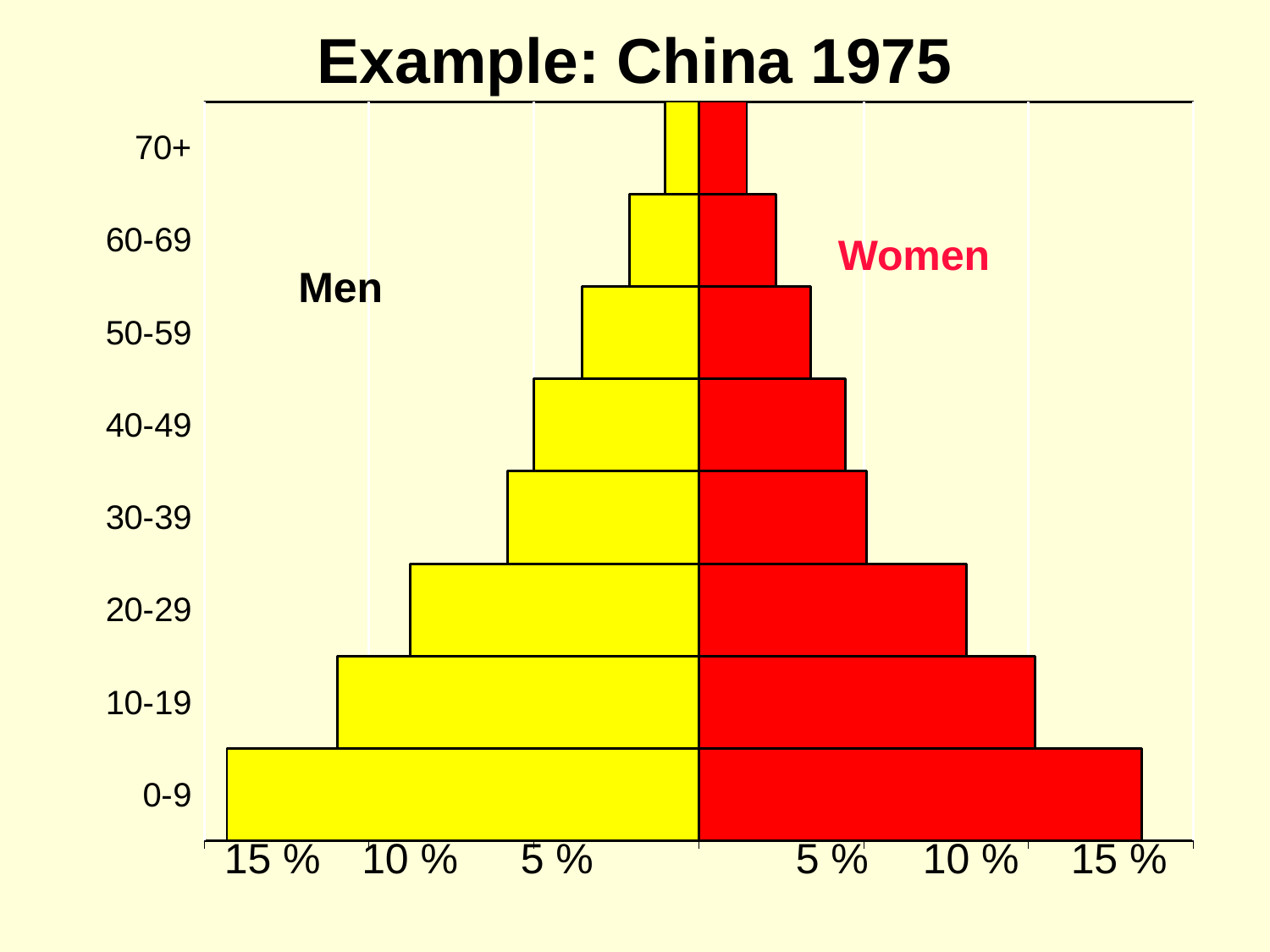
Which is larger, the share of men aged 10-19 or the share of men aged 30-39? men aged 10-19 How many series (population groups) does the chart show? 2 Is the value for men aged 0-9 greater or less than 10 %? greater Do the bar lengths increase or decrease as the age groups get older? decrease Is the value for women aged 50-59 greater or less than 5 %? less What colour are the bars for women? red What kind of chart is shown on the slide? bar chart (population pyramid) How many age groups are shown on the vertical axis? 8 Which age group has the smallest share of women? 70+ Is the value for women aged 10-19 greater or less than 15 %? less Which age group has the largest share of men? 0-9